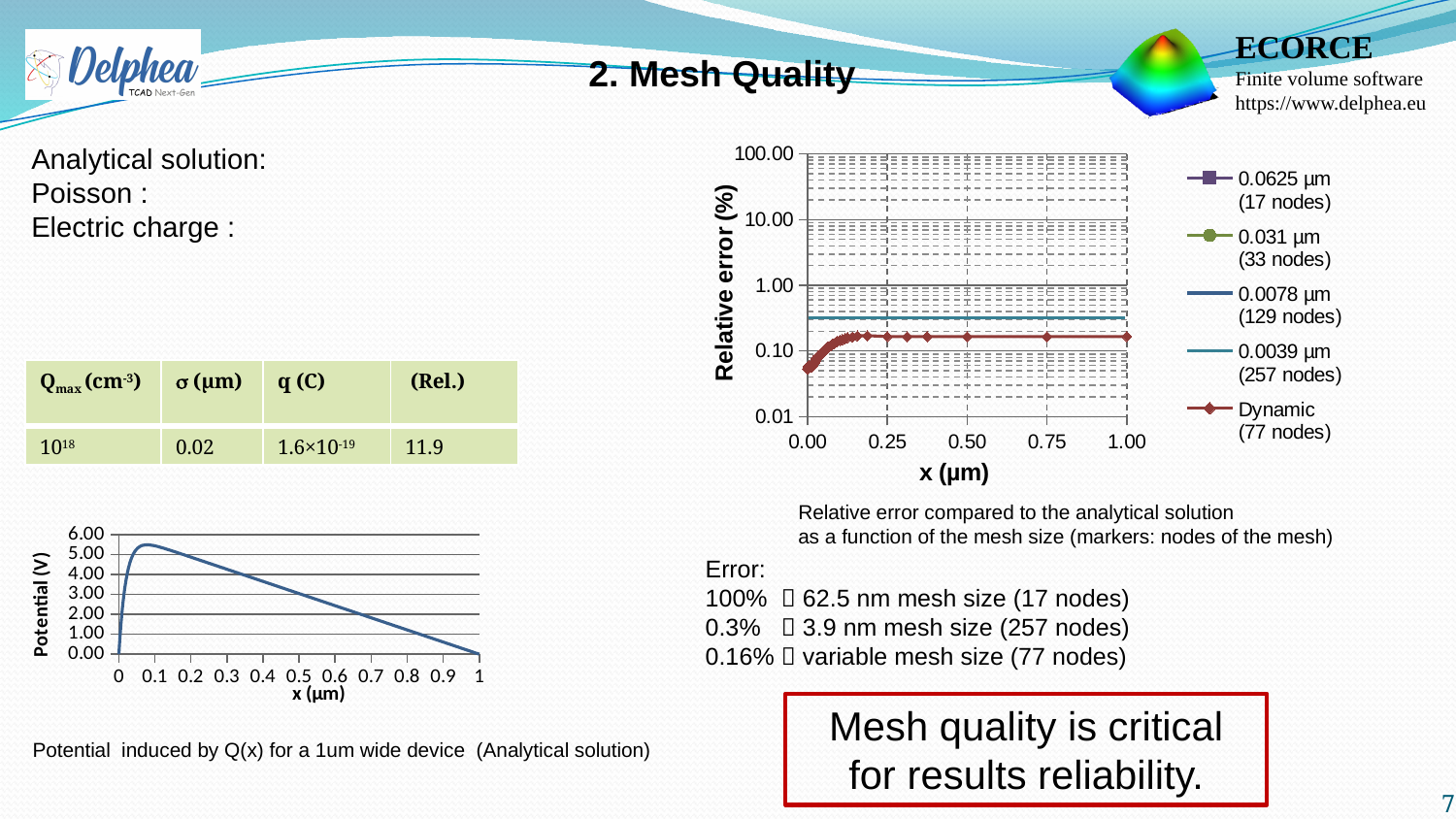
In the relative error chart, which legend entry corresponds to 77 nodes? Dynamic In the relative error chart, does the Dynamic (77 nodes) series rise or fall between x = 0.00 and x = 0.10? rise How many series does the legend of the relative error chart list? 5 What kind of chart is the 'Potential (V)' chart at the bottom left of the slide? line chart In the potential chart, is the potential at x = 0.1 greater or less than 4.00? greater What kind of chart is the 'Relative error (%)' chart on the right of the slide? line chart In the relative error chart, is the value of the Dynamic (77 nodes) series at x = 0.50 greater or less than 0.10? greater In the potential chart, is the potential at x = 1 greater or less than 1.00? less In the relative error chart, at x = 0.50, which series has the higher relative error: 0.0039 µm (257 nodes) or Dynamic (77 nodes)? 0.0039 µm (257 nodes) In the potential chart, does the potential rise or fall between x = 0.2 and x = 1? fall What is the y-axis label of the relative error chart? Relative error (%)